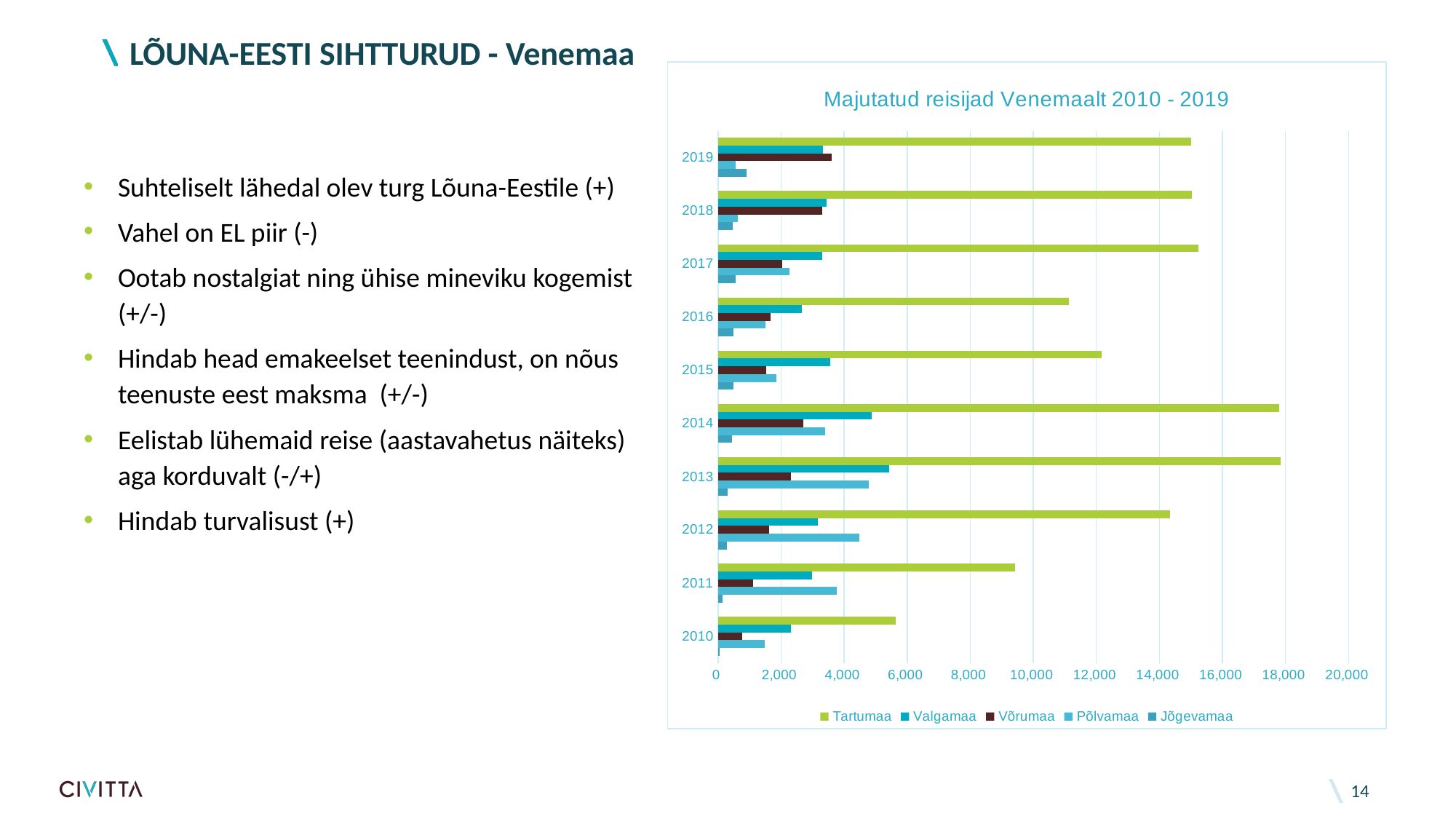
What kind of chart is shown on the slide? Bar chart How many years are shown on the chart's vertical axis? 10 Which is larger, the Tartumaa value for 2012 or for 2011? 2012 What is the title of the chart? Majutatud reisijad Venemaalt 2010 - 2019 Is the Tartumaa value for 2014 greater or less than 16,000? greater In which year is the Tartumaa value lowest? 2010 Which series has the shortest bar for 2019? Põlvamaa How many series does the chart legend list? 5 Is the Tartumaa value for 2019 greater or less than 14,000? greater Which series is shown in green in the chart? Tartumaa Is the Tartumaa value for 2011 greater or less than 10,000? less Do the Tartumaa values rise or fall from 2010 to 2013? rise